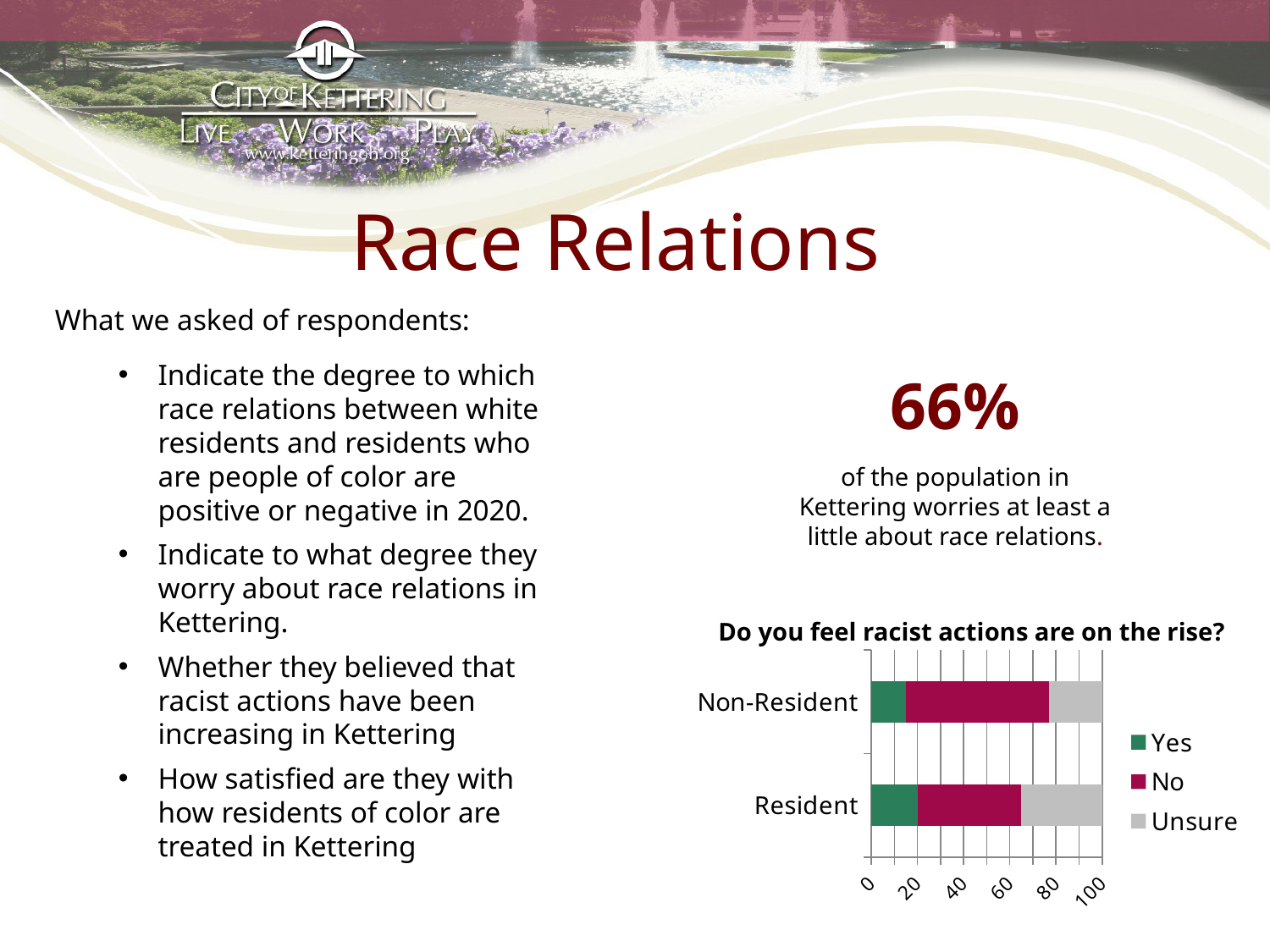
Is the 'Yes' value for Non-Resident greater or less than 20? less Is the 'No' value for Non-Resident greater or less than 40? greater Is the 'Unsure' value for Resident greater or less than 20? greater Which response is shown in green in the chart's legend? Yes How many series does the chart's legend list? 3 For the Non-Resident bar, which response makes up the largest segment? No Which group has the larger 'No' value, Non-Resident or Resident? Non-Resident What kind of chart is shown on the slide? bar chart Which group has the larger 'Unsure' value, Non-Resident or Resident? Resident What is the title of the chart on the slide? Do you feel racist actions are on the rise? How many categories are shown on the chart's vertical axis? 2